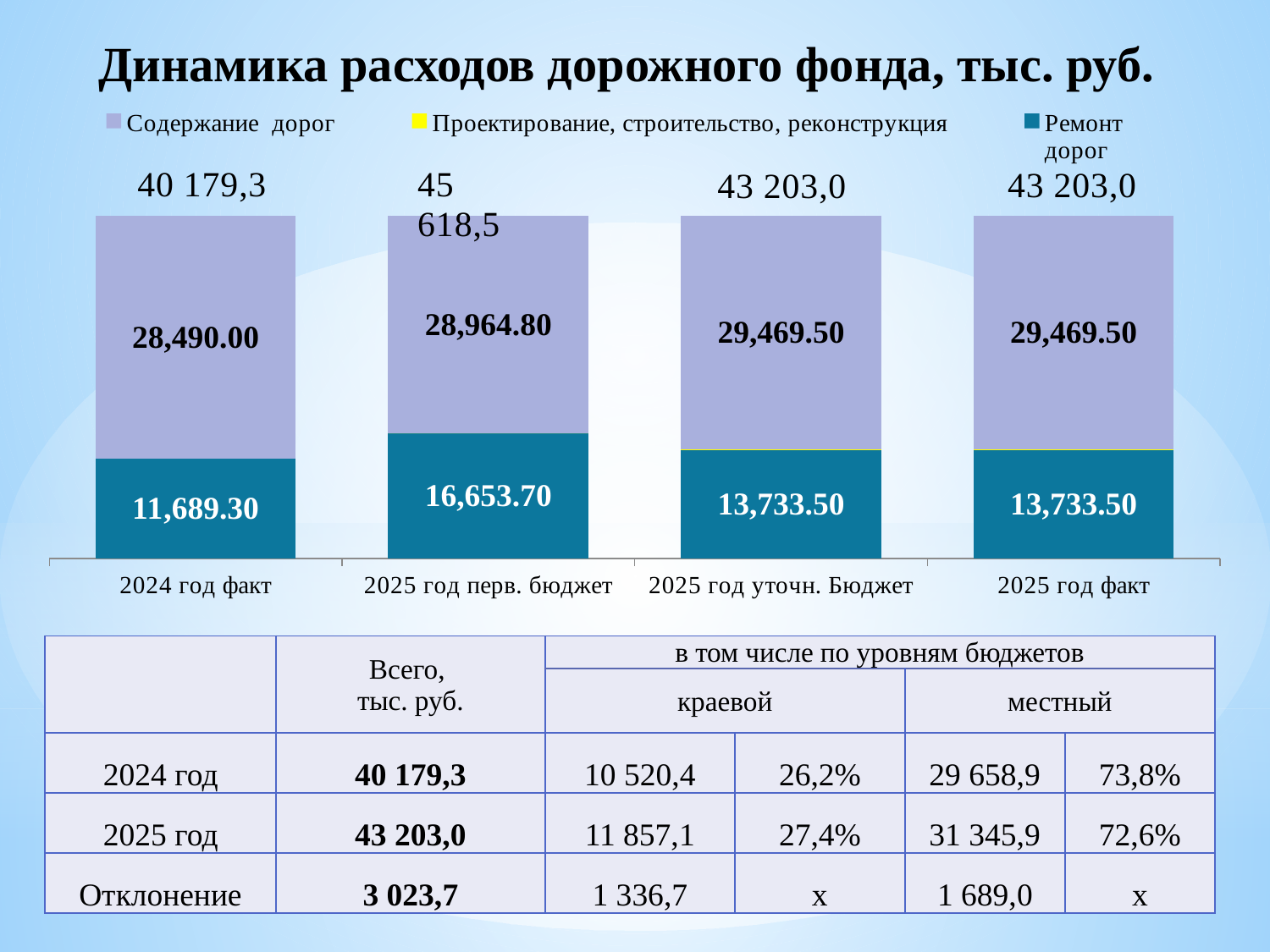
What is the total shown above the bar for 2024 год факт? 40 179,3 Which category has the lowest value for Ремонт дорог? 2024 год факт What is the value of Ремонт дорог for 2025 год факт? 13,733.50 Which is larger: Ремонт дорог for 2025 год перв. бюджет or for 2025 год уточн. Бюджет? 2025 год перв. бюджет Which category has the highest value for Ремонт дорог? 2025 год перв. бюджет What kind of chart is shown on the slide? stacked bar chart What is the difference between the Содержание дорог values for 2025 год уточн. Бюджет and 2024 год факт? 979.50 What is the value of Ремонт дорог for 2025 год перв. бюджет? 16,653.70 How many categories are shown on the x axis of the chart? 4 What is the total shown above the bar for 2025 год перв. бюджет? 45 618,5 What is the value of Содержание дорог for 2024 год факт? 28,490.00 How many series does the chart legend list? 3